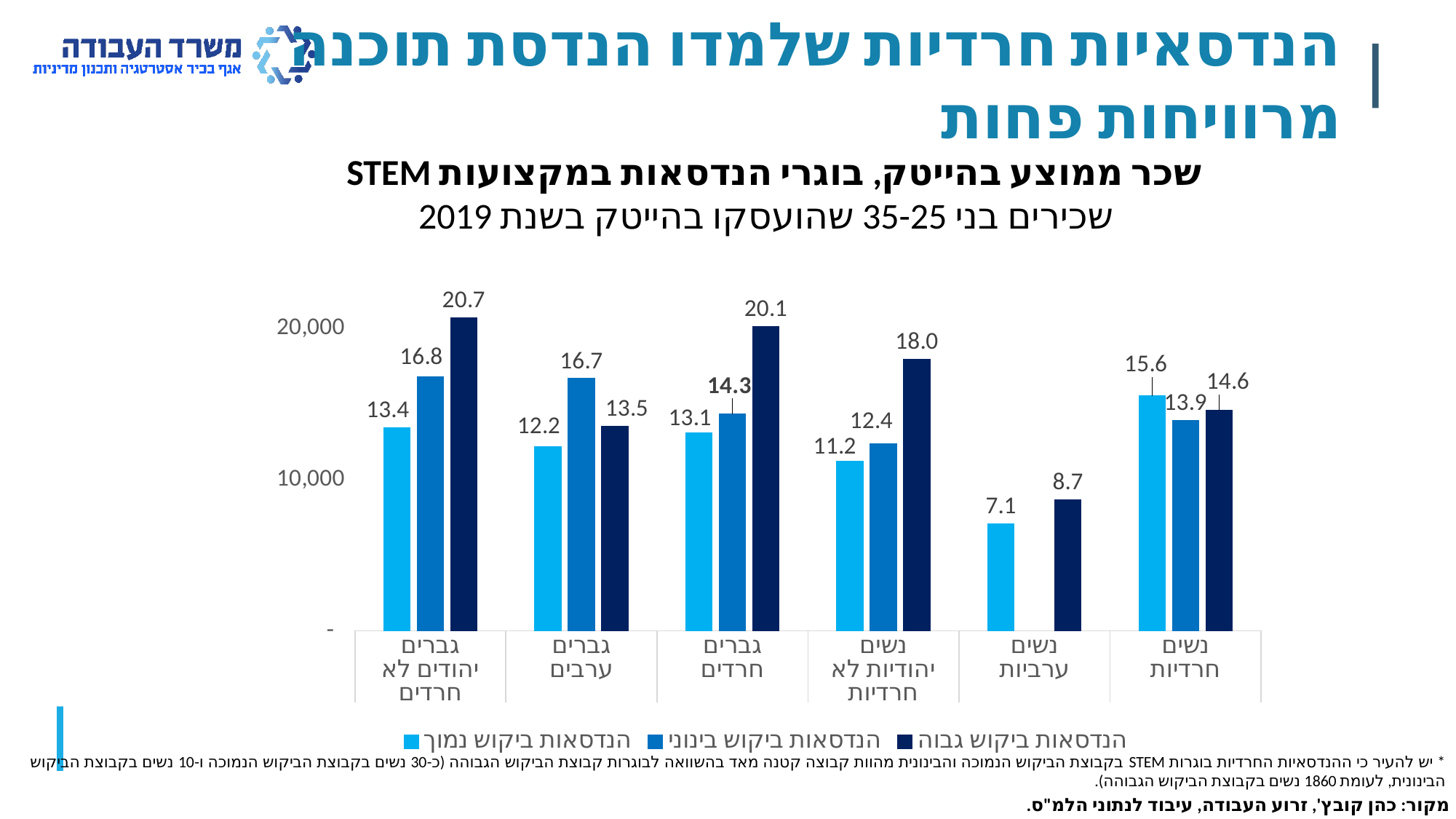
Is the value for הנדסאות ביקוש גבוה in the category נשים ערביות greater or less than 10,000? less Which category has the lowest value for הנדסאות ביקוש נמוך? נשים ערביות What is the value for הנדסאות ביקוש גבוה in the category גברים יהודים לא חרדים? 20.7 What type of chart is shown on the slide? bar chart In the category נשים חרדיות, which is larger: הנדסאות ביקוש נמוך or הנדסאות ביקוש גבוה? הנדסאות ביקוש נמוך Which category is missing a bar for הנדסאות ביקוש בינוני? נשים ערביות What is the value for הנדסאות ביקוש בינוני in the category גברים חרדים? 14.3 Which category has the highest value for הנדסאות ביקוש גבוה? גברים יהודים לא חרדים How many categories are shown on the x axis? 6 What is the difference between הנדסאות ביקוש גבוה and הנדסאות ביקוש נמוך in the category נשים יהודיות לא חרדיות? 6.7 What is the value for הנדסאות ביקוש נמוך in the category נשים ערביות? 7.1 How many series does the legend list? 3